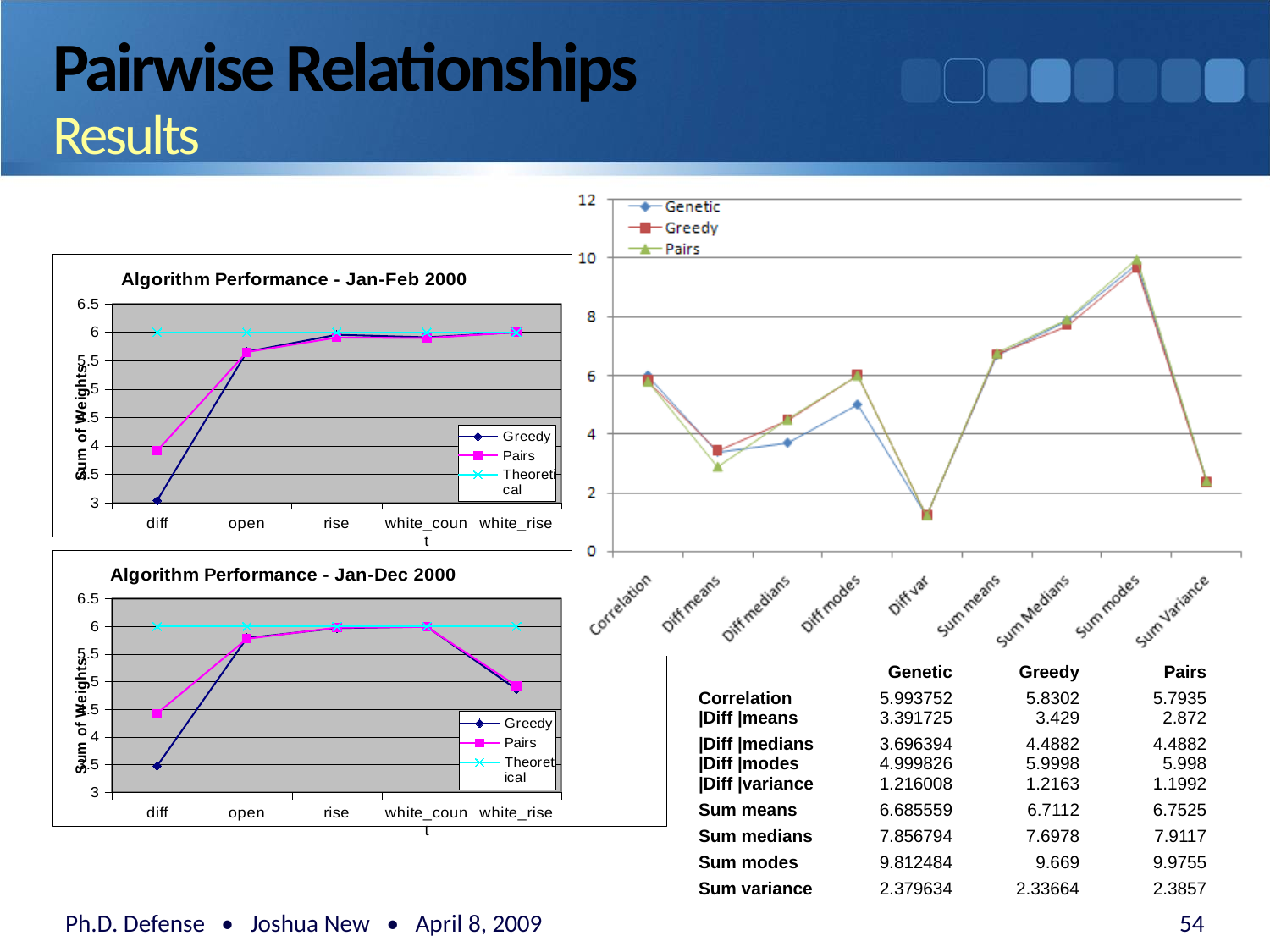
How many series does the legend of the large line chart on the right list? 3 In the large line chart on the right, which is larger at Diff means: Genetic or Pairs? Genetic In the 'Algorithm Performance - Jan-Feb 2000' chart, which series is drawn as a flat line at 6? Theoretical In the 'Algorithm Performance - Jan-Dec 2000' chart, is the Greedy value for white_rise greater or less than 5? less In the 'Algorithm Performance - Jan-Dec 2000' chart, does the Greedy series rise or fall from diff to open? rise In the large line chart on the right, which category has the highest value for all three series? Sum modes In the large line chart on the right, what is the Genetic value for Sum modes? 9.812484 In the large line chart on the right, which category has the lowest value for all three series? Diff var What kind of chart is the 'Algorithm Performance - Jan-Feb 2000' chart? line chart In the 'Algorithm Performance - Jan-Feb 2000' chart, is the Greedy value for diff greater or less than 4? less How many series does the legend of the 'Algorithm Performance - Jan-Dec 2000' chart list? 3 How many categories are shown on the x axis of the 'Algorithm Performance - Jan-Feb 2000' chart? 5